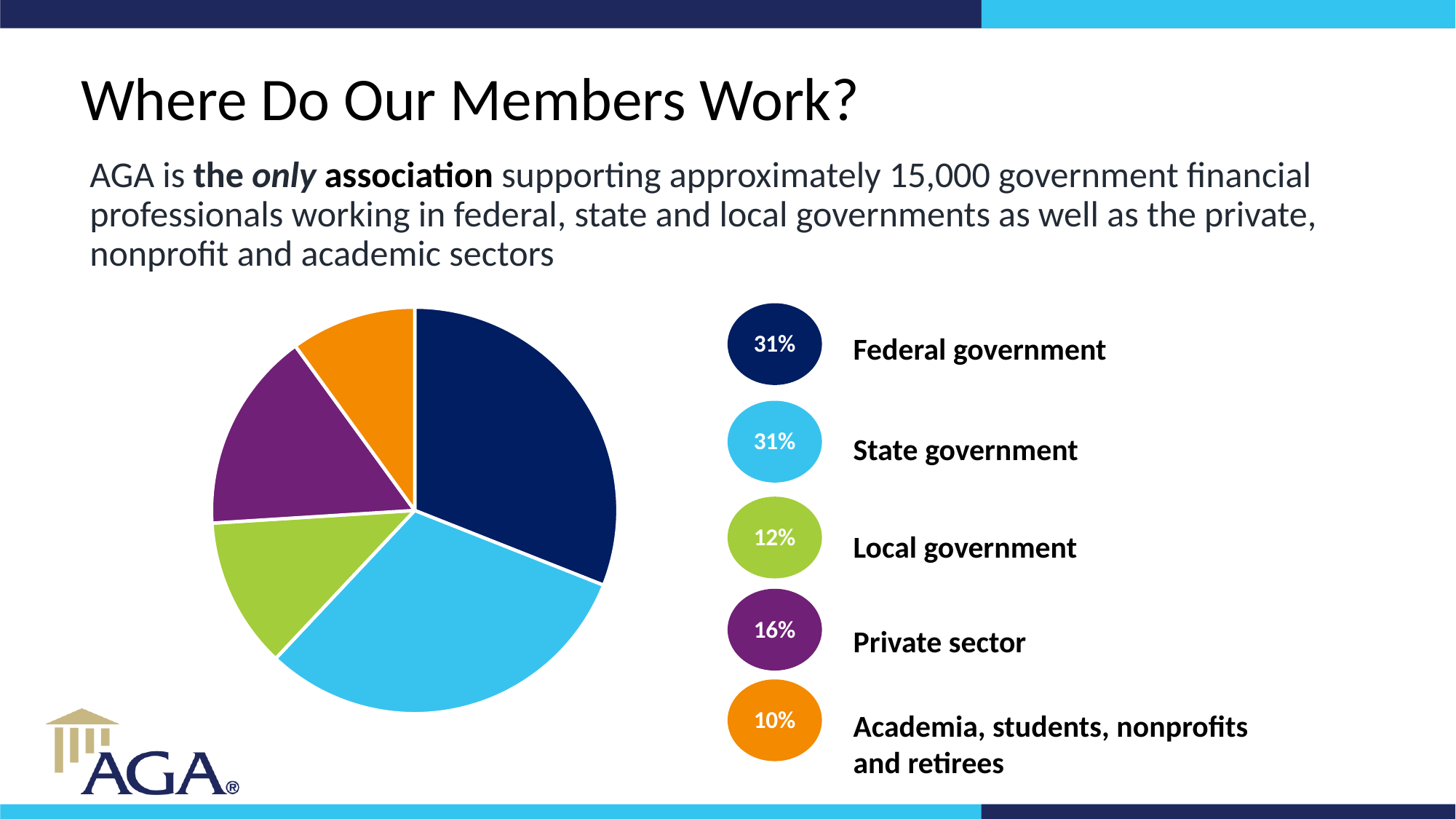
What is the difference in percentage points between the private sector share and the local government share? 4 percentage points What share of members work in local government? 12% What share of members work in state government? 31% What share of members work in the private sector? 16% What colour is the slice for state government? Light blue What kind of chart is shown on the slide? Pie chart What is the title of the slide containing the pie chart? Where Do Our Members Work? Which category has the smallest share of members? Academia, students, nonprofits and retirees How many categories does the pie chart show? 5 Which is larger, the share for the private sector or the share for local government? Private sector